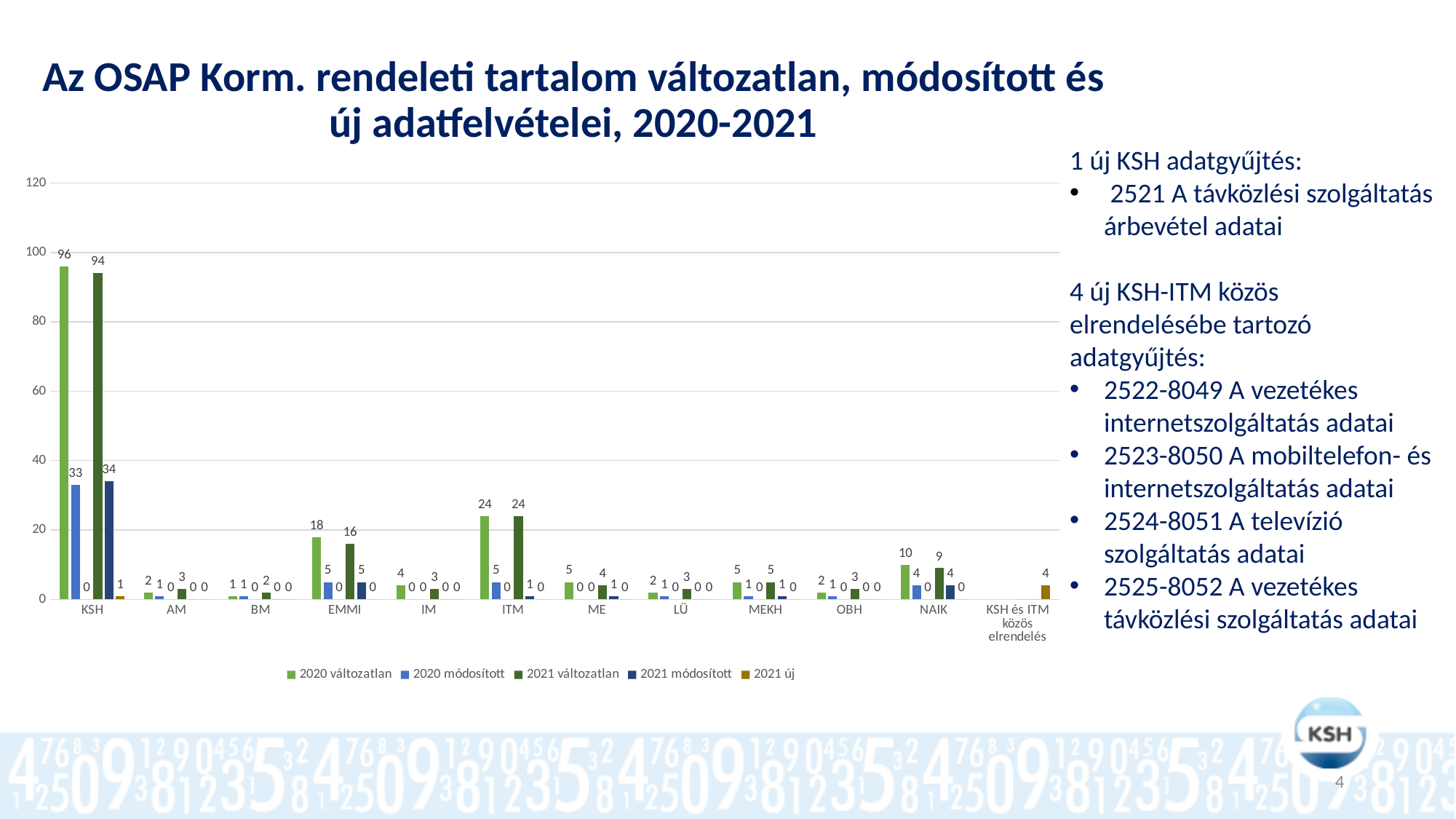
What is the value of the 2020 módosított series for NAIK? 4 What is the value of the 2021 új series for KSH és ITM közös elrendelés? 4 Is the 2021 módosított value for KSH greater or less than 20? greater What kind of chart is shown on the slide? bar chart How many categories are shown on the x axis? 12 What is the difference between the 2020 változatlan and 2021 változatlan values for KSH? 2 Which category has the highest value in the 2021 változatlan series? KSH What is the value of the 2021 változatlan series for EMMI? 16 How many series does the legend list? 5 Which is larger for ITM: the 2020 változatlan value or the 2020 módosított value? 2020 változatlan What is the value of the 2020 változatlan series for KSH? 96 What is the value of the 2021 módosított series for ITM? 1